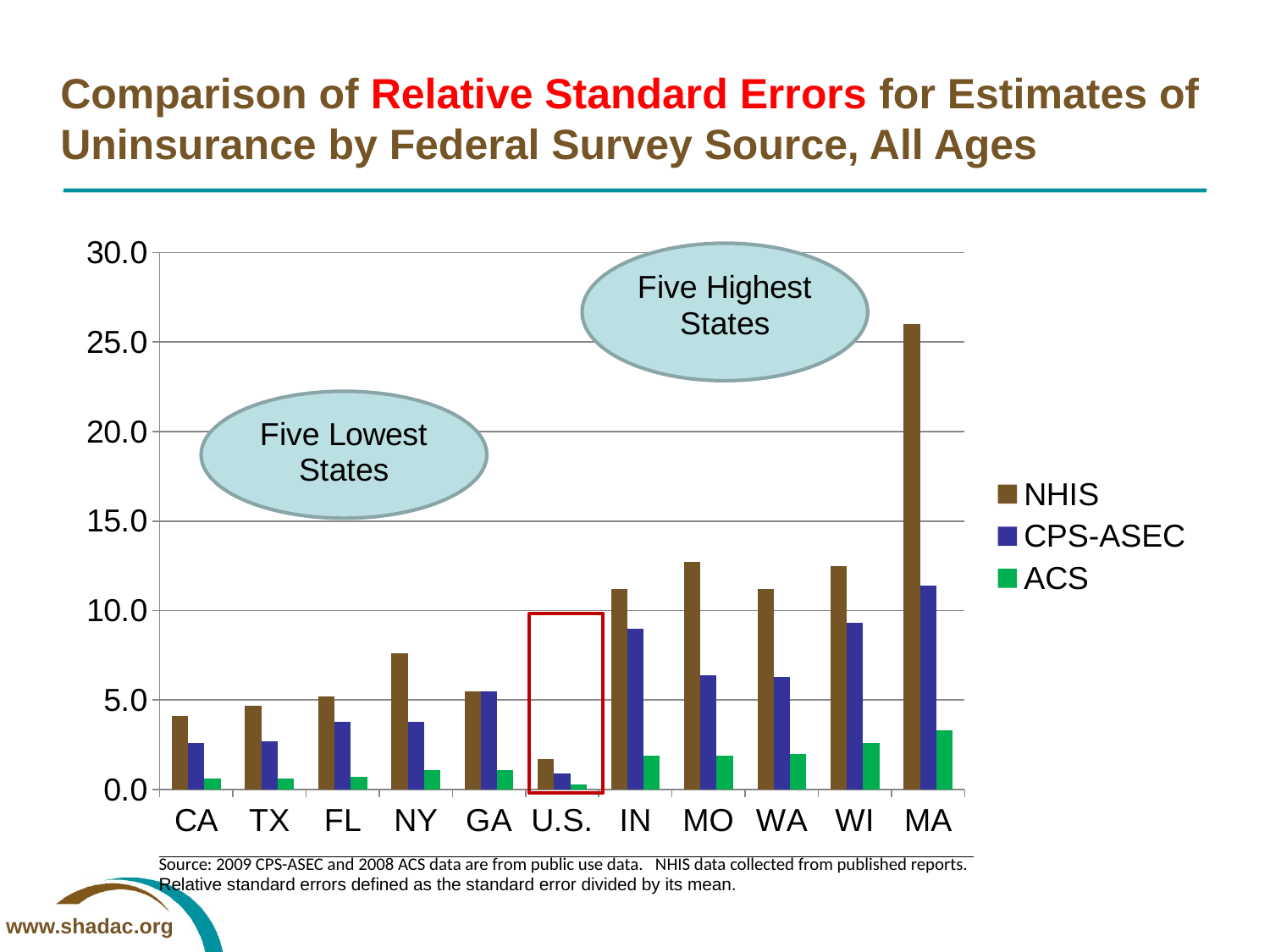
What kind of chart is shown on the slide? bar chart Which is larger, the CPS-ASEC value for IN or the CPS-ASEC value for MO? IN Which category has the lowest NHIS value? U.S. Which category has the highest CPS-ASEC value? MA How many categories are shown along the x axis? 11 Which series is shown in green in the legend? ACS Is the CPS-ASEC value for IN greater or less than 10.0? less Which is larger, the NHIS value for NY or the NHIS value for GA? NY Which category has the highest NHIS value? MA Is the NHIS value for NY greater or less than 5.0? greater Is the NHIS value for MA greater or less than 20.0? greater How many series does the legend list? 3